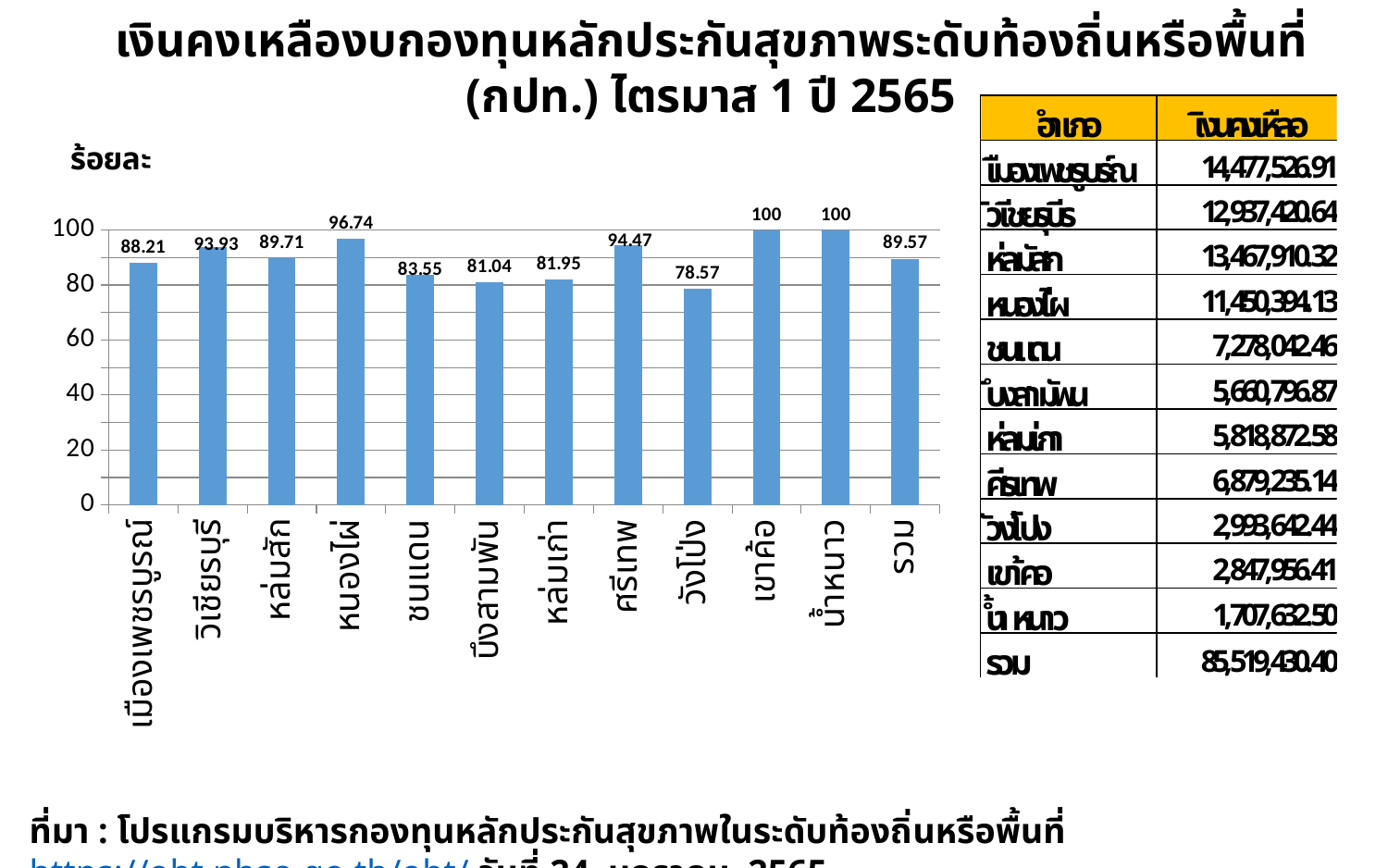
How many categories are shown on the x axis of the bar chart? 12 Which is larger in the bar chart, the value for วิเชียรบุรี or the value for หล่มสัก? วิเชียรบุรี Which category has the lowest value in the bar chart? วังโป่ง What is the value for ศรีเทพ in the bar chart? 94.47 What is the label shown above the y axis of the bar chart? ร้อยละ What is the value for วังโป่ง in the bar chart? 78.57 What is the difference between the values for หนองไผ่ and ชนแดน in the bar chart? 13.19 What is the value for หนองไผ่ in the bar chart? 96.74 Which two categories in the bar chart have a value of 100? เขาค้อ and น้ำหนาว What is the value for รวม in the bar chart? 89.57 What type of chart is shown on the slide? bar chart Is the value for บึงสามพัน in the bar chart greater or less than 80? greater